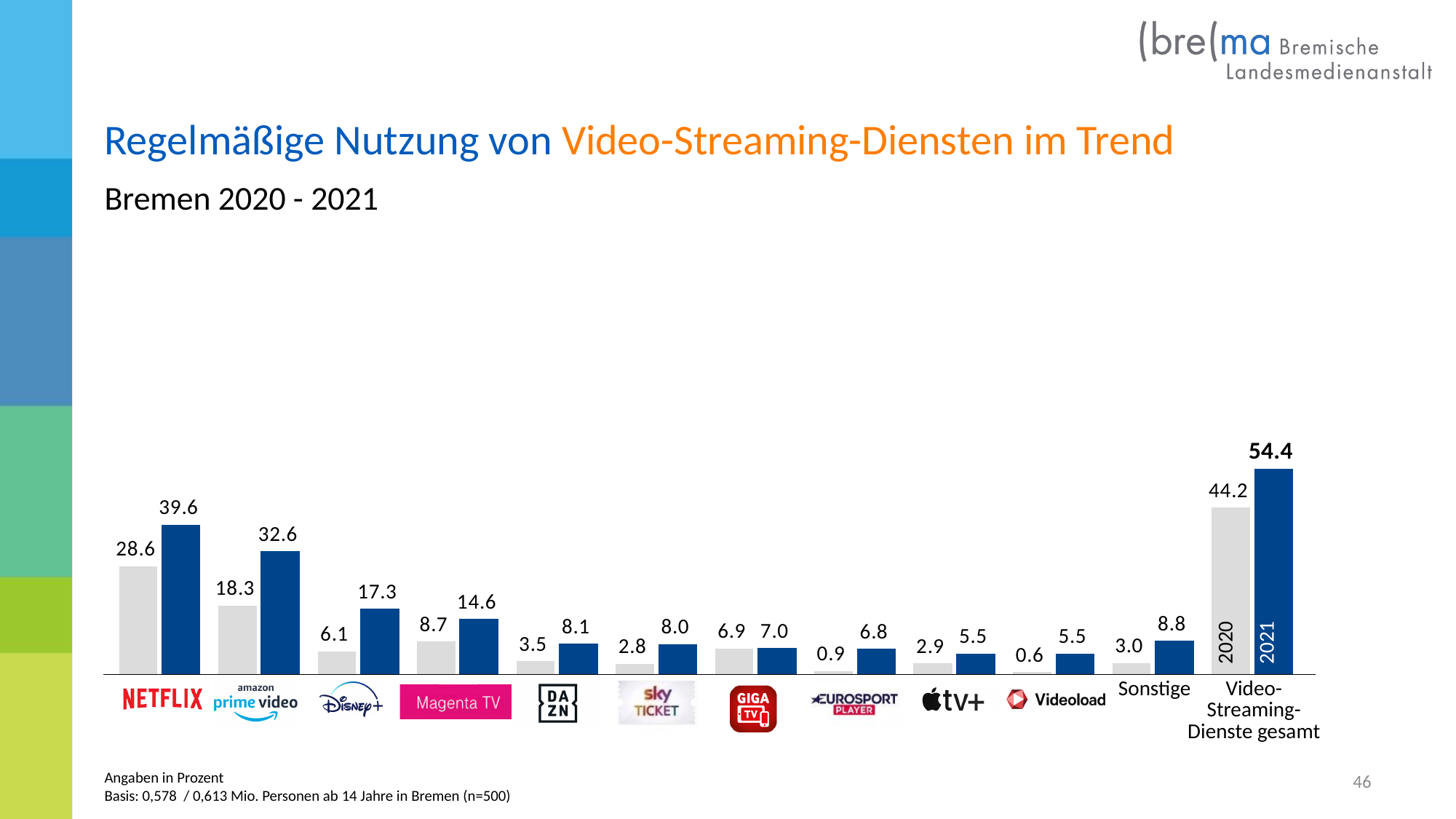
What is the 2020 value for Video-Streaming-Dienste gesamt? 44.2 Which individual streaming service (excluding Sonstige and the gesamt total) has the highest 2021 value? Netflix Which category has the lowest 2020 value? Videoload What is the 2021 value for Netflix? 39.6 Which is larger: the 2021 value for DAZN or the 2021 value for Sky Ticket? DAZN What is the difference between the 2021 and 2020 values for Video-Streaming-Dienste gesamt? 10.2 What is the 2020 value for Amazon Prime Video? 18.3 What type of chart is shown on the slide? Bar chart How many data series does the chart show? 2 What is the difference between the 2021 and 2020 values for Netflix? 11.0 What is the 2021 value for Disney+? 17.3 How many categories are shown on the x axis of the chart? 12